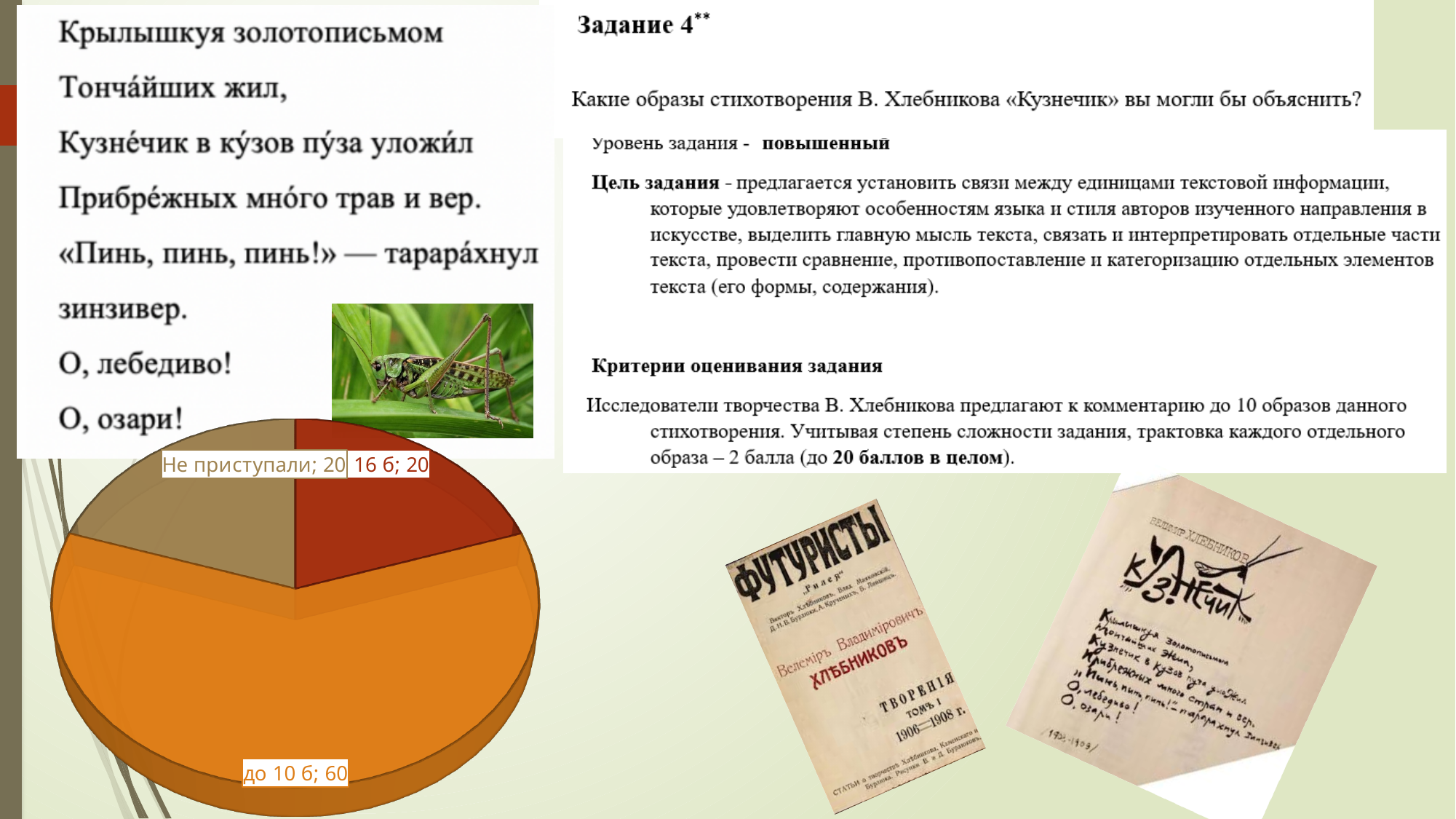
What is the value of the "Не приступали" slice in the pie chart? 20 What colour is the "до 10 б" slice in the pie chart? orange What is the value of the "16 б" slice in the pie chart? 20 What is the difference between the "до 10 б" slice and the "16 б" slice in the pie chart? 40 What kind of chart is shown on the slide? pie chart How many slices does the pie chart have? 3 What share of the pie chart does the "до 10 б" slice represent? 60% What is the total of all slices in the pie chart? 100 What share of the pie chart does the "16 б" slice represent? 20% Which slice of the pie chart is the largest? до 10 б What is the value of the "до 10 б" slice in the pie chart? 60 Which is larger in the pie chart: the "до 10 б" slice or the "Не приступали" slice? до 10 б